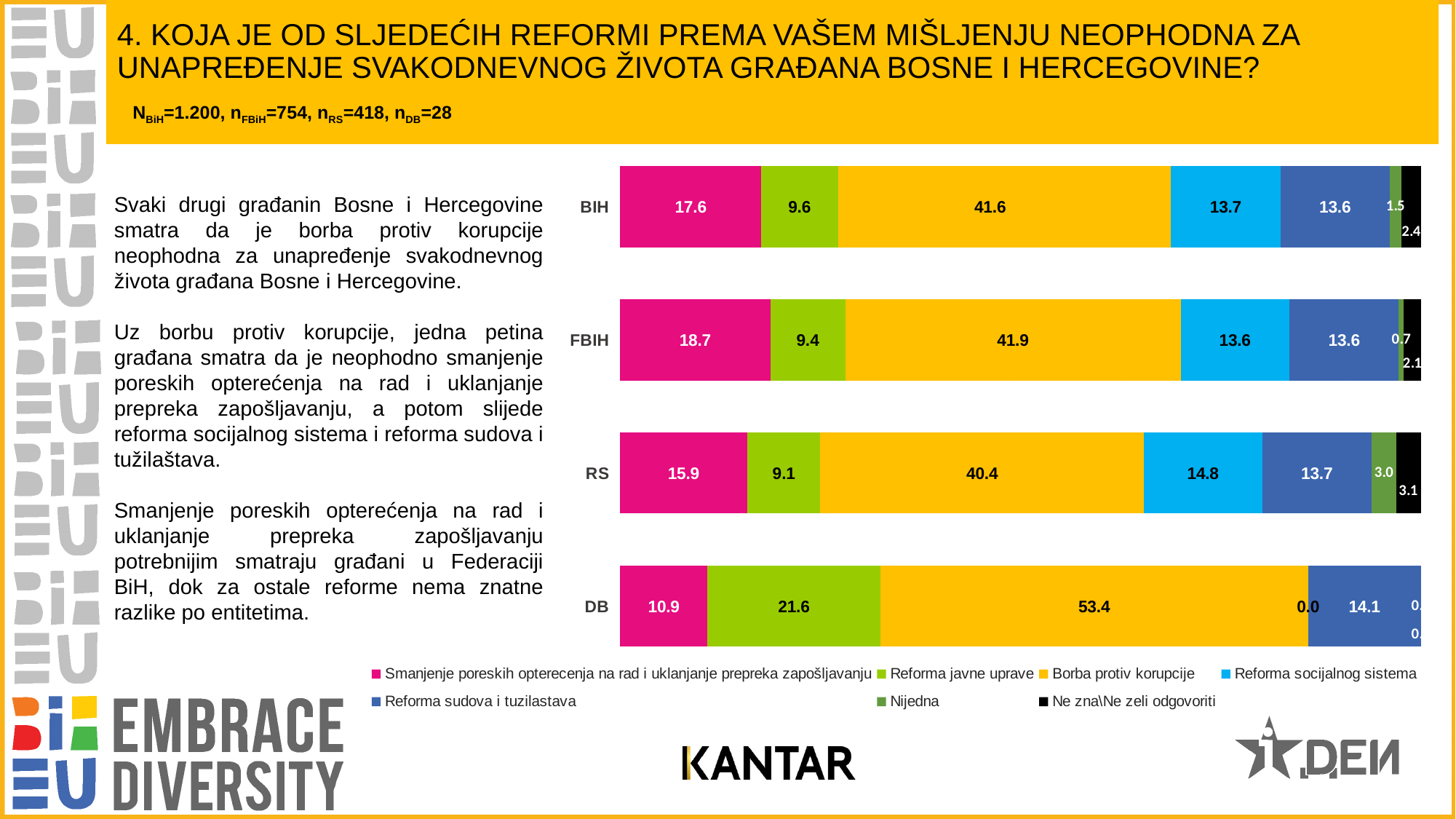
What is the value for Borba protiv korupcije in the BIH bar? 41.6 What is the value for Smanjenje poreskih opterecenja na rad i uklanjanje prepreka zapošljavanju in the FBIH bar? 18.7 Which category has the highest value for Borba protiv korupcije? DB How many categories (bars) are shown in the chart? 4 How many series does the legend list? 7 What is the difference between the Smanjenje poreskih opterecenja values for FBIH and RS? 2.8 What is the value for Reforma javne uprave in the DB bar? 21.6 What kind of chart is shown on the slide? Stacked bar chart What is the value for Reforma socijalnog sistema in the RS bar? 14.8 What is the total of the BIH stacked bar? 100.0 Which category has the lowest value for Smanjenje poreskih opterecenja na rad i uklanjanje prepreka zapošljavanju? DB Which is larger: the Reforma javne uprave value for DB or for BIH? DB